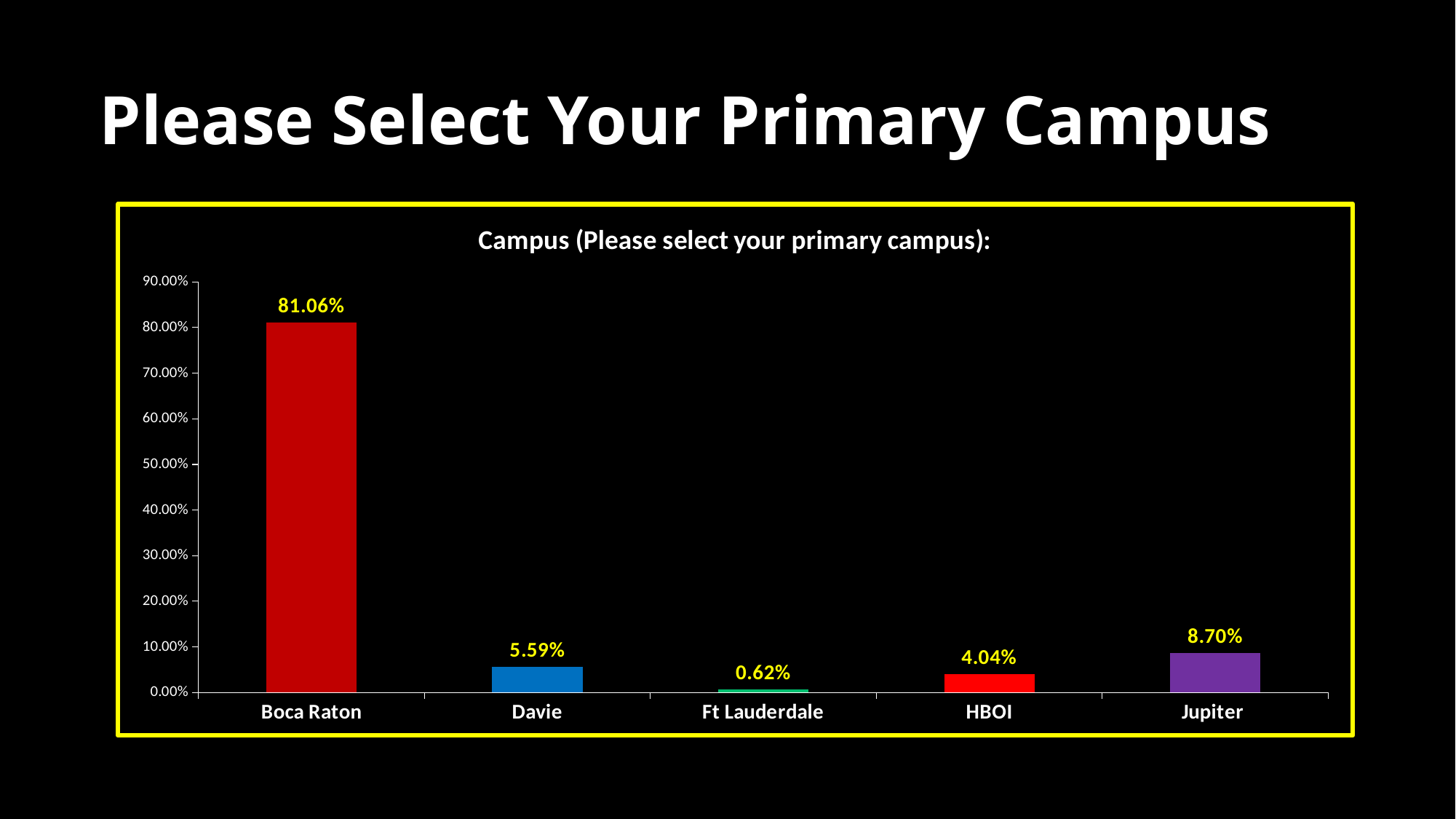
What is the value for Jupiter? 8.70% What is the difference between the values for Jupiter and Davie? 3.11% What is the value for Boca Raton? 81.06% Which campus has the highest value? Boca Raton What is the title of the chart? Campus (Please select your primary campus): Is the value for Boca Raton greater or less than 80.00%? greater Which is larger, the value for Davie or the value for HBOI? Davie What is the value for HBOI? 4.04% What is the value for Ft Lauderdale? 0.62% How many campuses are shown on the x axis? 5 What kind of chart is shown? bar chart Which campus has the lowest value? Ft Lauderdale